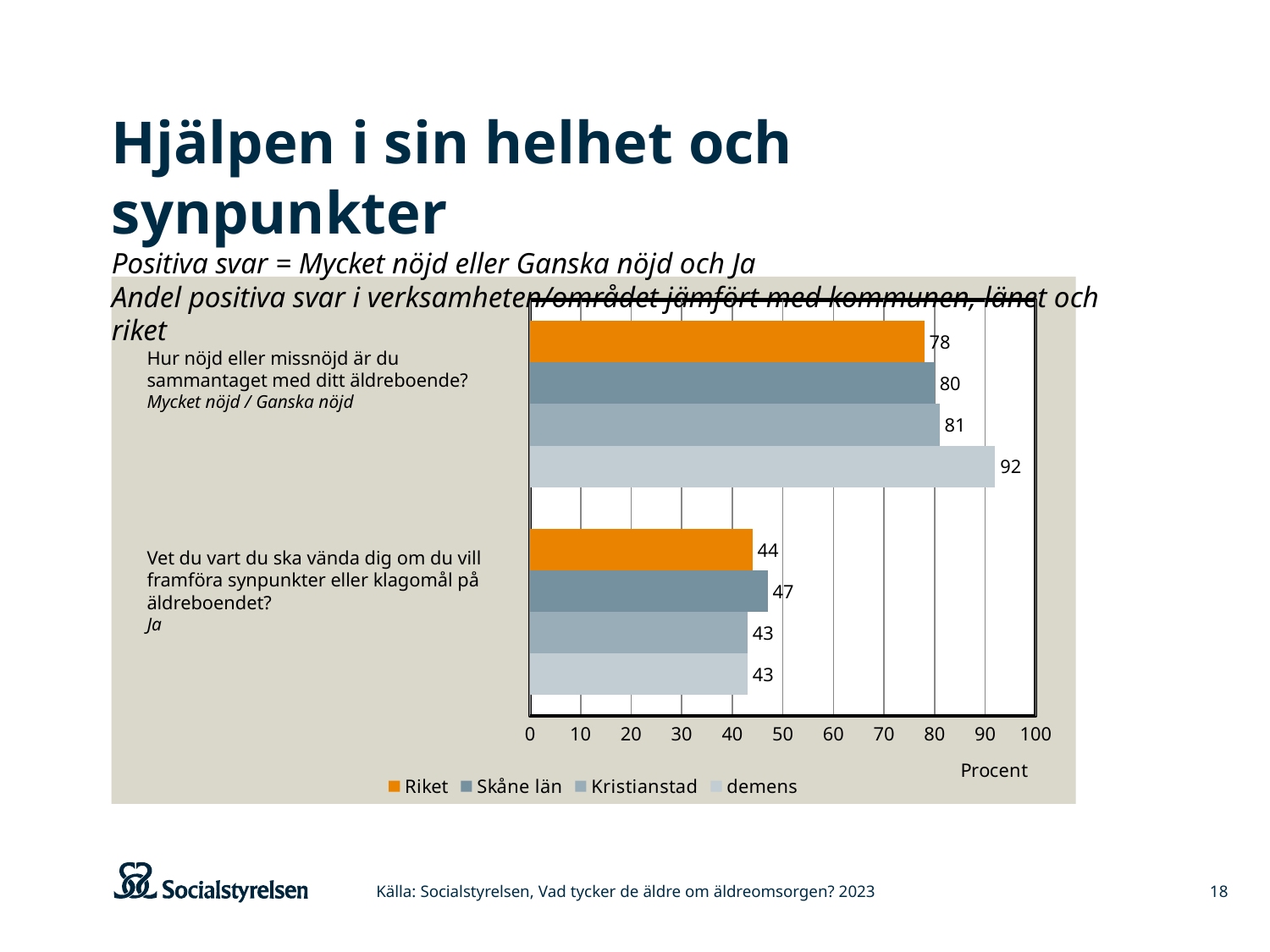
How many series does the legend list? 4 Which series has the lowest value on the question "Hur nöjd eller missnöjd är du sammantaget med ditt äldreboende?"? Riket What is the value for Skåne län on the question "Vet du vart du ska vända dig om du vill framföra synpunkter eller klagomål på äldreboendet?"? 47 What unit label is shown under the x axis of the chart? Procent Which series has the highest value on the question "Vet du vart du ska vända dig om du vill framföra synpunkter eller klagomål på äldreboendet?"? Skåne län Which series has the highest value on the question "Hur nöjd eller missnöjd är du sammantaget med ditt äldreboende?"? demens What type of chart is shown on the slide? bar chart What is the value for Kristianstad on the question "Vet du vart du ska vända dig om du vill framföra synpunkter eller klagomål på äldreboendet?"? 43 What is the value for demens on the question "Hur nöjd eller missnöjd är du sammantaget med ditt äldreboende?"? 92 Is the value for Riket on the question "Vet du vart du ska vända dig om du vill framföra synpunkter eller klagomål på äldreboendet?" greater or less than 50? less What is the value for Riket on the question "Hur nöjd eller missnöjd är du sammantaget med ditt äldreboende?"? 78 What is the difference between the demens value and the Riket value on the question "Hur nöjd eller missnöjd är du sammantaget med ditt äldreboende?"? 14